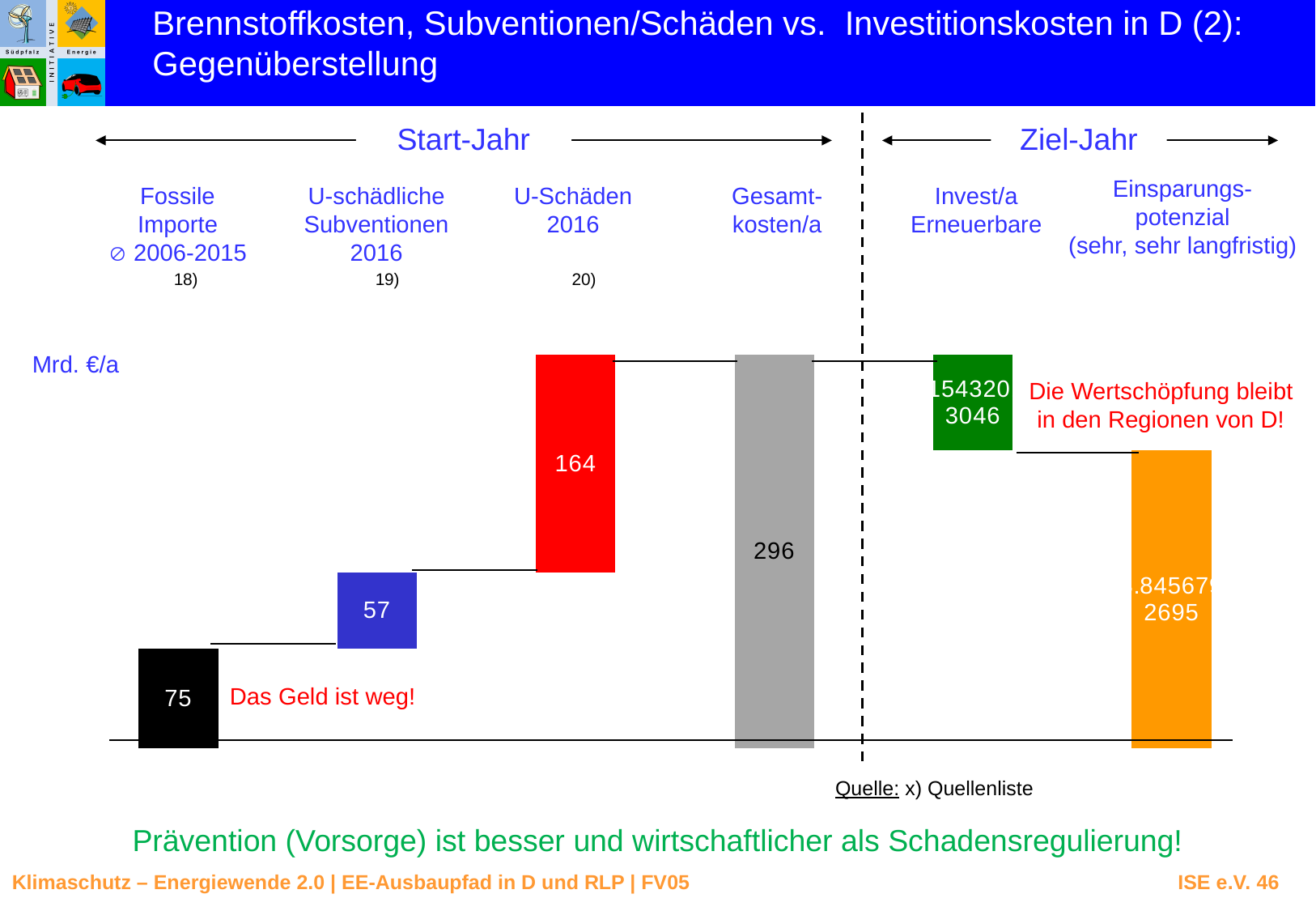
What kind of chart is shown on the slide? bar chart Among the three Start-Jahr components (Fossile Importe, U-schädliche Subventionen, U-Schäden), which has the highest value? U-Schäden 2016 What unit is shown on the chart's value axis? Mrd. €/a What is the difference between Gesamtkosten/a and Fossile Importe? 221 Which is larger, Fossile Importe or U-schädliche Subventionen 2016? Fossile Importe What is the value for Fossile Importe (⌀ 2006-2015)? 75 What is the value for Gesamtkosten/a? 296 How many bars are plotted in the chart? 6 What is the value for U-schädliche Subventionen 2016? 57 What is the value for U-Schäden 2016? 164 What is the sum of Fossile Importe, U-schädliche Subventionen 2016 and U-Schäden 2016? 296 What is the difference between U-Schäden 2016 and U-schädliche Subventionen 2016? 107